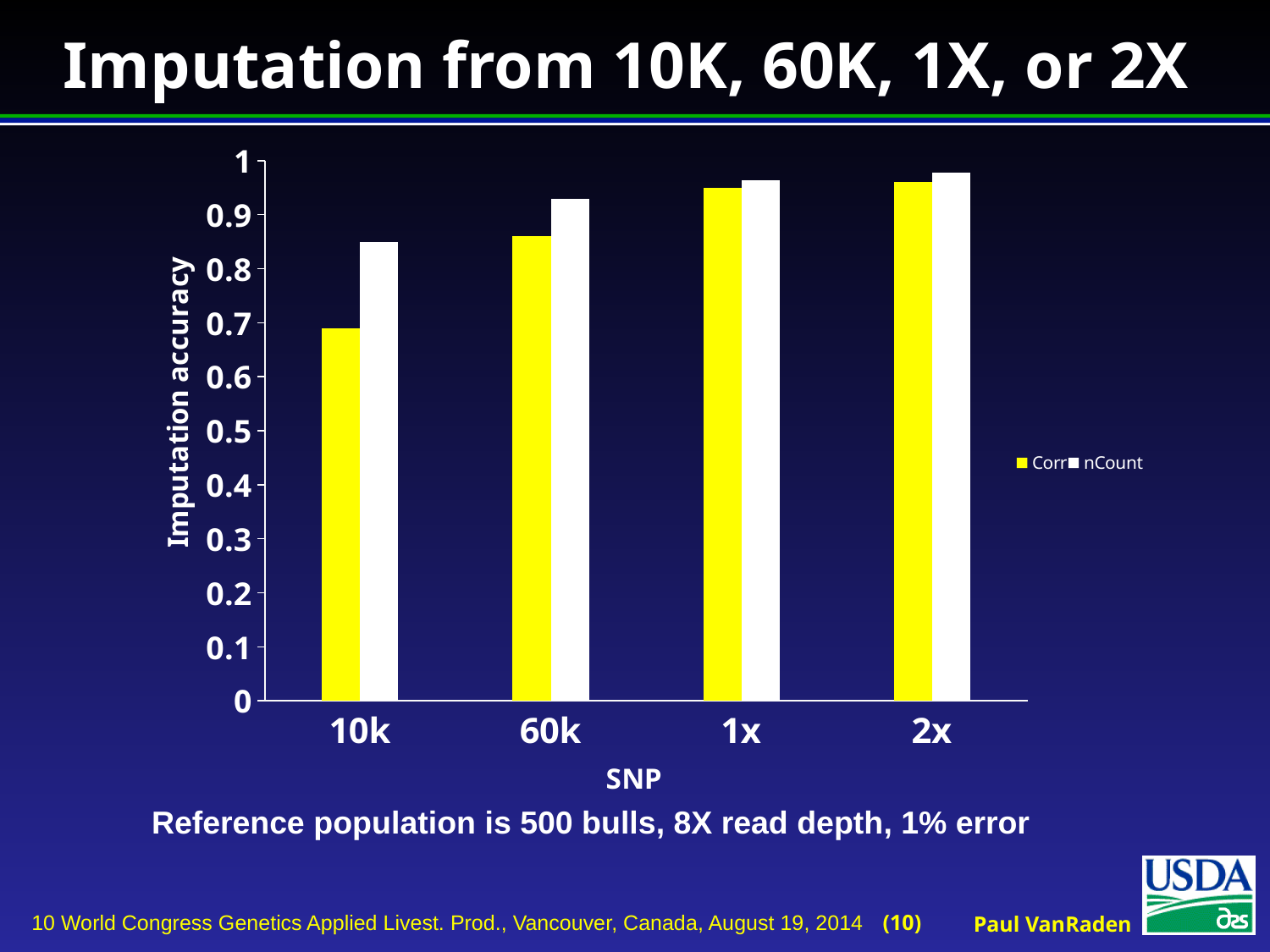
Is the nCount value for 10k greater or less than 0.8? greater How many series does the chart's legend list? 2 Is the Corr value for 10k greater or less than 0.8? less What is the label of the chart's y axis? Imputation accuracy Is the Corr value for 1x greater or less than 0.9? greater What kind of chart is shown on the slide? bar chart Which category has the lowest Corr value? 10k Which category has the lowest nCount value? 10k How many categories are shown on the x axis of the chart? 4 Do the Corr values rise or fall moving from 10k to 2x along the x axis? rise For the 10k category, which series has the larger value, Corr or nCount? nCount